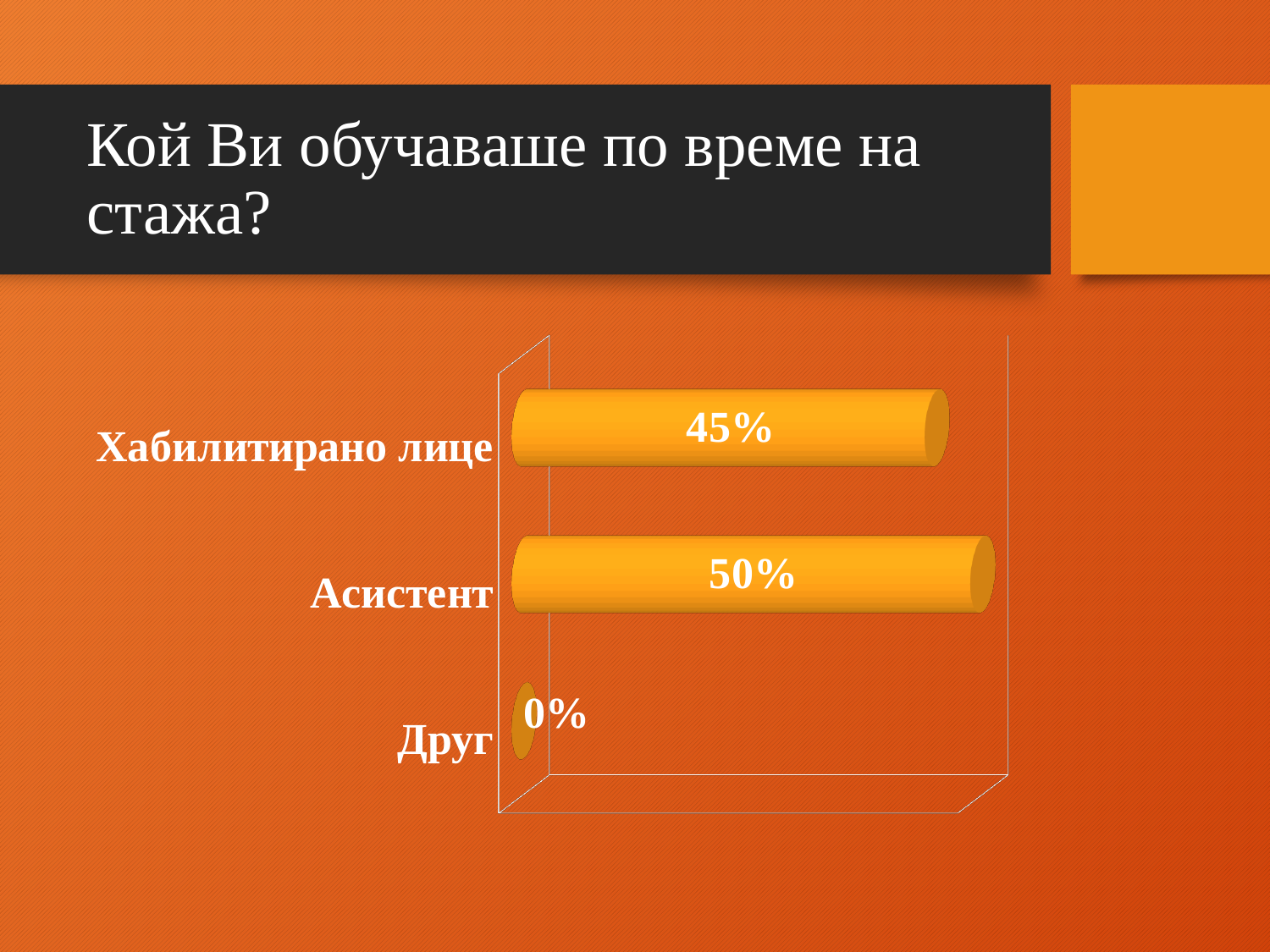
What kind of chart is shown on the slide? Bar chart What is the value for Хабилитирано лице? 45% Which category has the highest value? Асистент What is the value for Асистент? 50% What is the title of the slide containing the chart? Кой Ви обучаваше по време на стажа? What is the difference between the values for Хабилитирано лице and Друг? 45% Which is larger, the value for Хабилитирано лице or the value for Асистент? Асистент Which category has the lowest value? Друг How many categories are shown in the chart? 3 What colour are the bars in the chart? Orange What is the difference between the values for Асистент and Хабилитирано лице? 5% What is the value for Друг? 0%